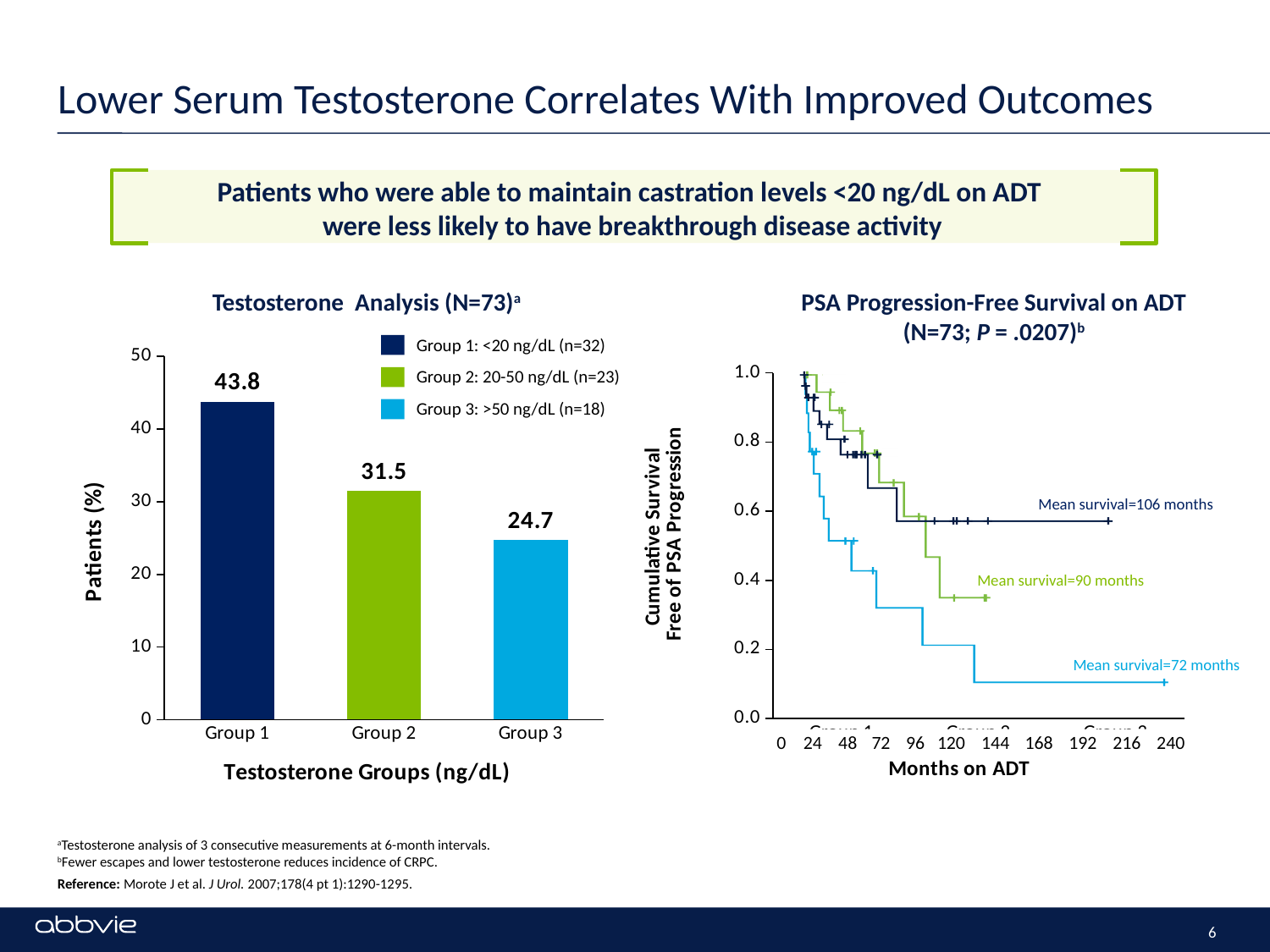
In the Testosterone Analysis chart, what percentage of patients is shown for Group 2? 31.5 In the Testosterone Analysis chart, what percentage of patients is shown for Group 3? 24.7 In the Testosterone Analysis chart, what percentage of patients is shown for Group 1? 43.8 In the Testosterone Analysis chart, which is larger, the value for Group 2 or Group 3? Group 2 In the PSA Progression-Free Survival chart, what is the mean survival shown for the Group 1 curve? 106 months In the Testosterone Analysis chart, which group has the lowest percentage of patients? Group 3 In the Testosterone Analysis chart, what is the difference between the values for Group 1 and Group 3? 19.1 In the Testosterone Analysis chart, do the values rise or fall from Group 1 to Group 3? Fall What kind of chart is the Testosterone Analysis chart? Bar chart In the Testosterone Analysis chart, what testosterone range does the legend give for Group 2? 20-50 ng/dL (n=23) In the Testosterone Analysis chart, which group has the highest percentage of patients? Group 1 In the Testosterone Analysis chart, how many groups are plotted? 3